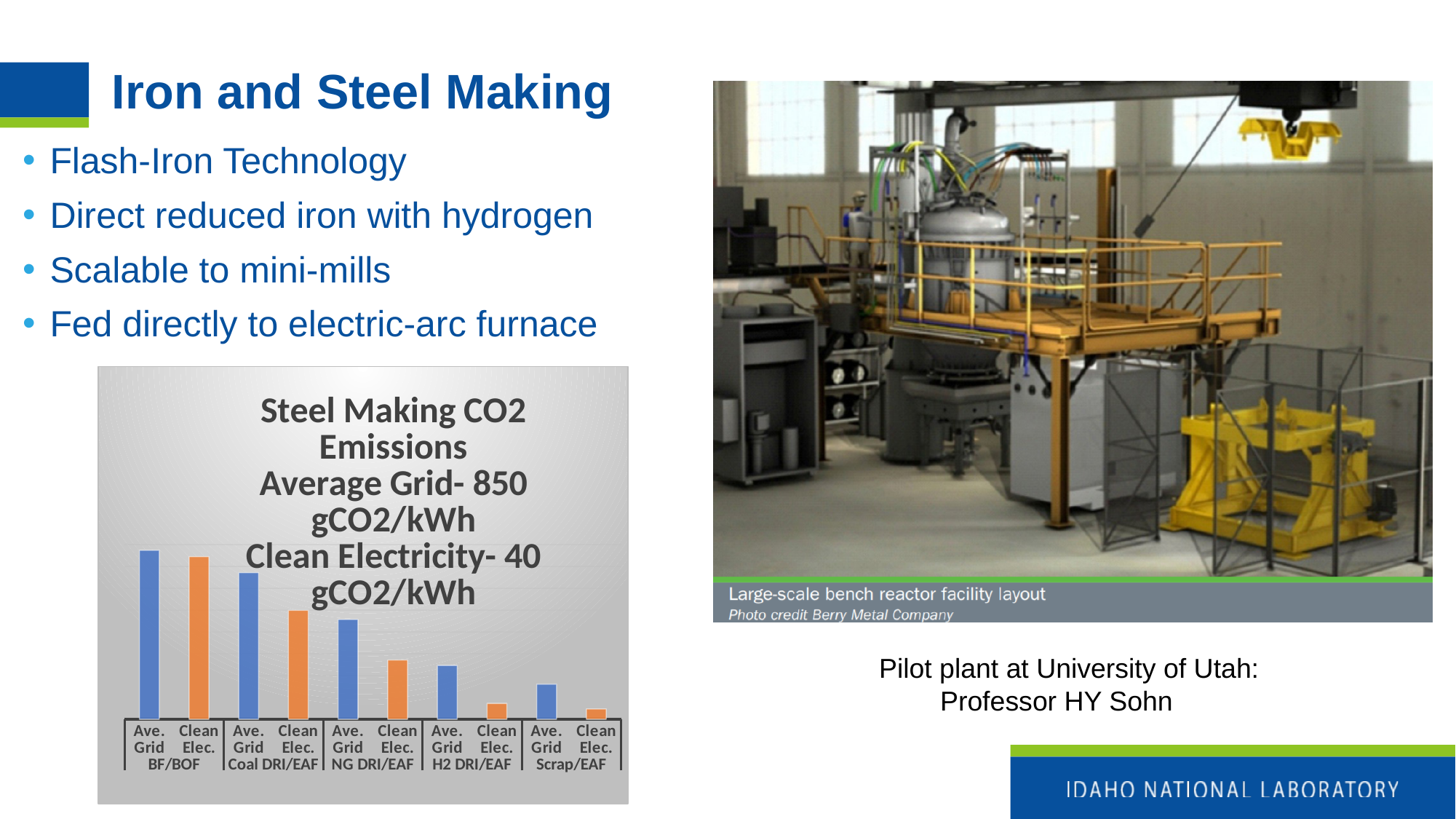
What kind of chart is shown on the slide? bar chart Which process has the highest Ave. Grid emissions in the chart? BF/BOF Which bar in the chart is the shortest? Clean Elec. Scrap/EAF What colour are the Clean Elec. bars in the chart? orange How many process categories (groups) are shown along the x axis of the chart? 5 Do the Ave. Grid bars rise or fall moving from BF/BOF to Scrap/EAF along the x axis? fall Which is larger: the Clean Elec. bar for BF/BOF or the Ave. Grid bar for Coal DRI/EAF? Clean Elec. BF/BOF For Coal DRI/EAF, which is larger: the Ave. Grid bar or the Clean Elec. bar? Ave. Grid What is the first line of the chart's title? Steel Making CO2 Which bar in the chart is the tallest? Ave. Grid BF/BOF Which process has the lowest Clean Elec. emissions in the chart? Scrap/EAF How many bars are plotted in the chart in total? 10